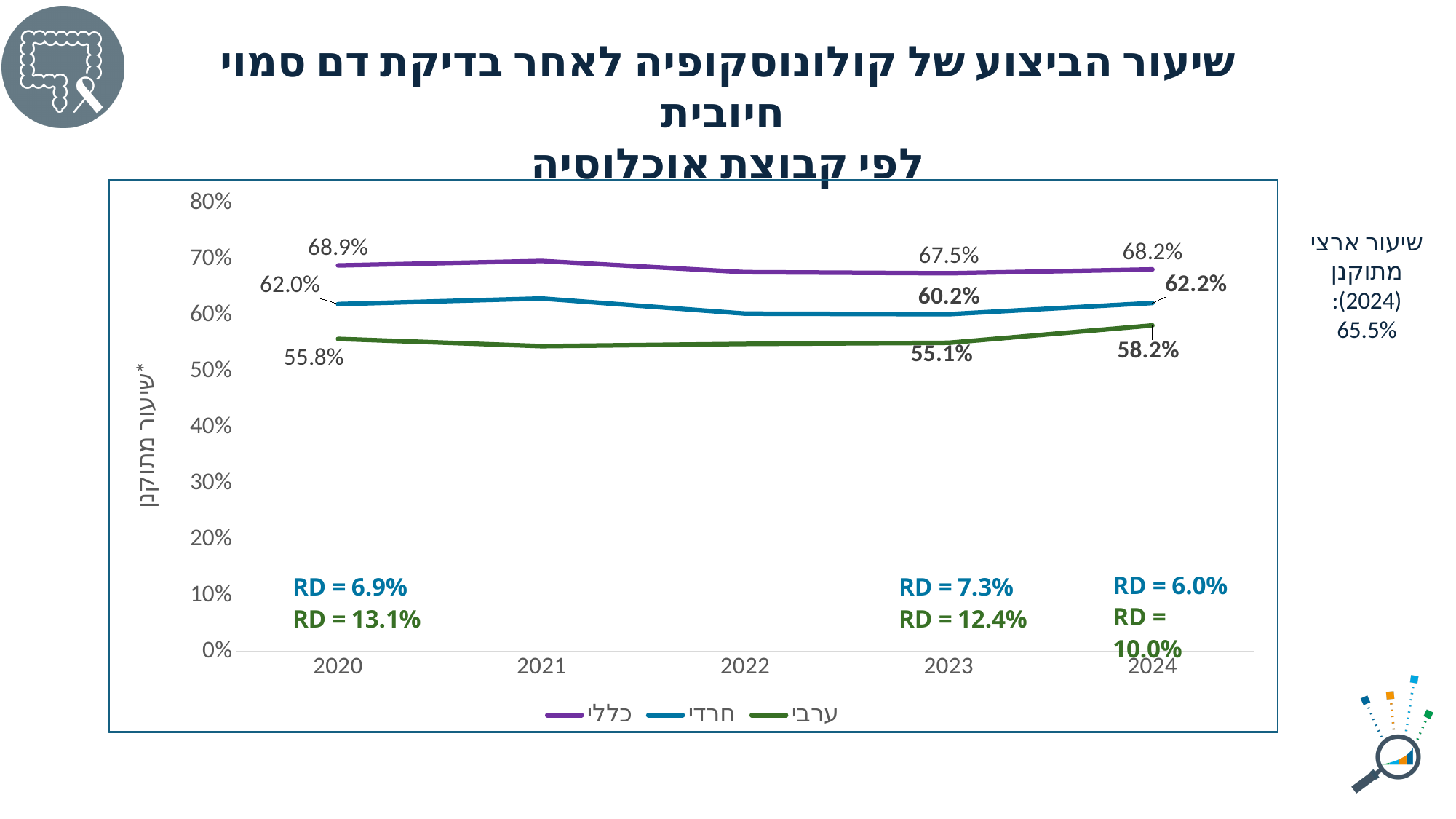
How many years are shown on the x axis? 5 How many series does the legend list? 3 Which series has the lowest value in 2024? ערבי What is the national adjusted rate (שיעור ארצי מתוקנן) for 2024 shown beside the chart? 65.5% Is the value for the ערבי series in 2021 greater or less than 60%? less What kind of chart is shown on the slide? line chart What is the value for the חרדי series in 2024? 62.2% Which is larger, the חרדי value in 2020 or the חרדי value in 2024? 2024 Which series has the highest value in 2023? כללי What is the value for the ערבי series in 2023? 55.1% What is the difference between the כללי and ערבי values in 2020? 13.1% What is the value for the כללי series in 2020? 68.9%